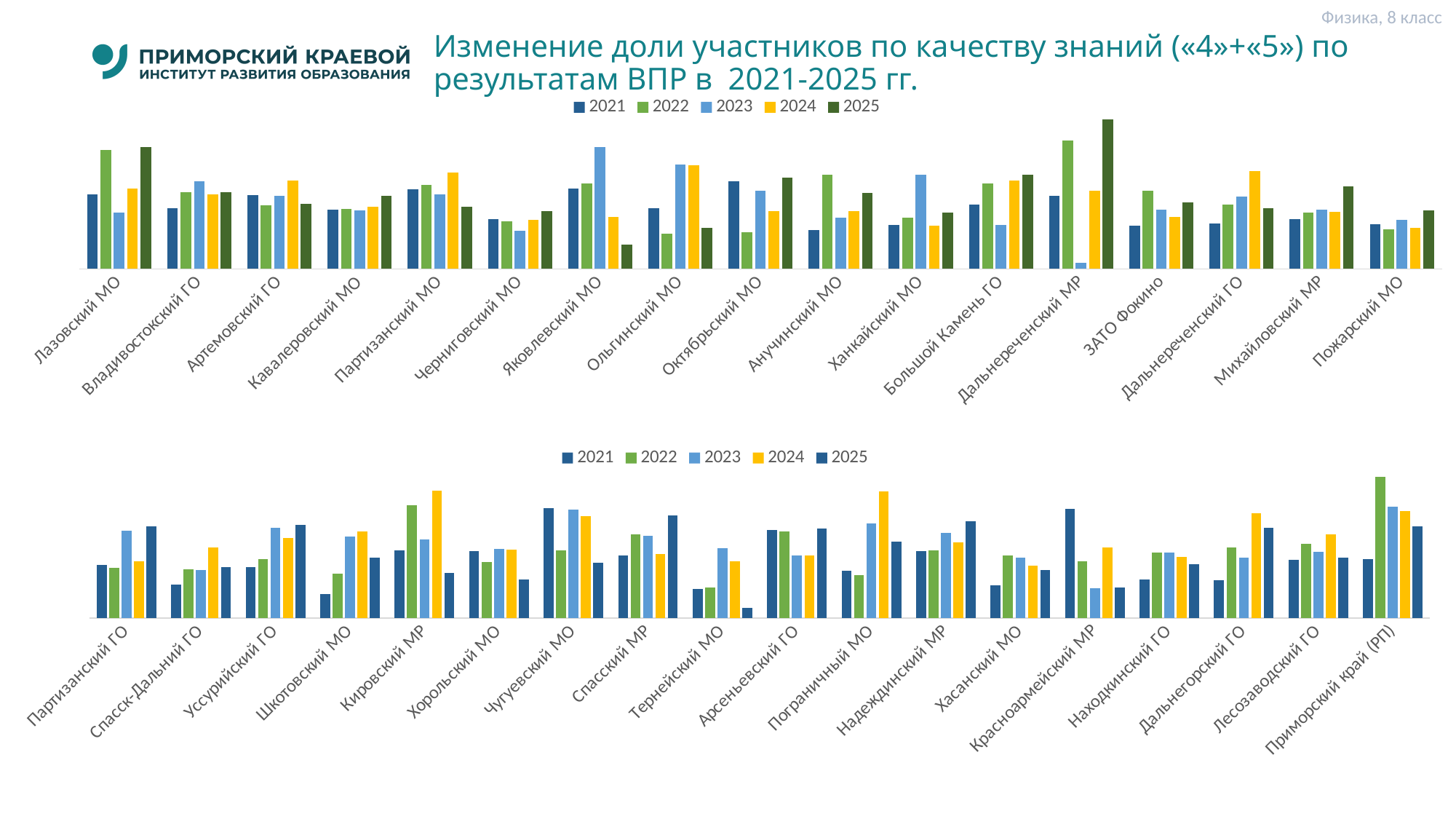
In the top chart, which category has the lowest 2025 bar? Яковлевский МО In the top chart, which category has the lowest 2023 bar? Дальнереченский МР How many series does the legend of the top chart list? 5 In the bottom chart, which category has the tallest 2022 bar? Приморский край (РП) In the bottom chart, which category has the lowest 2025 bar? Тернейский МО In the top chart, which category has the tallest 2025 bar? Дальнереченский МР In the top chart, for Лазовский МО, which is larger: the 2021 bar or the 2022 bar? 2022 What kind of chart is the top chart on the slide? bar chart Which years are listed in the legend of the bottom chart? 2021, 2022, 2023, 2024, 2025 How many categories (municipalities) are shown on the x axis of the bottom chart? 18 How many categories (municipalities) are shown on the x axis of the top chart? 17 In the bottom chart, for Чугуевский МО, which is larger: the 2021 bar or the 2025 bar? 2021